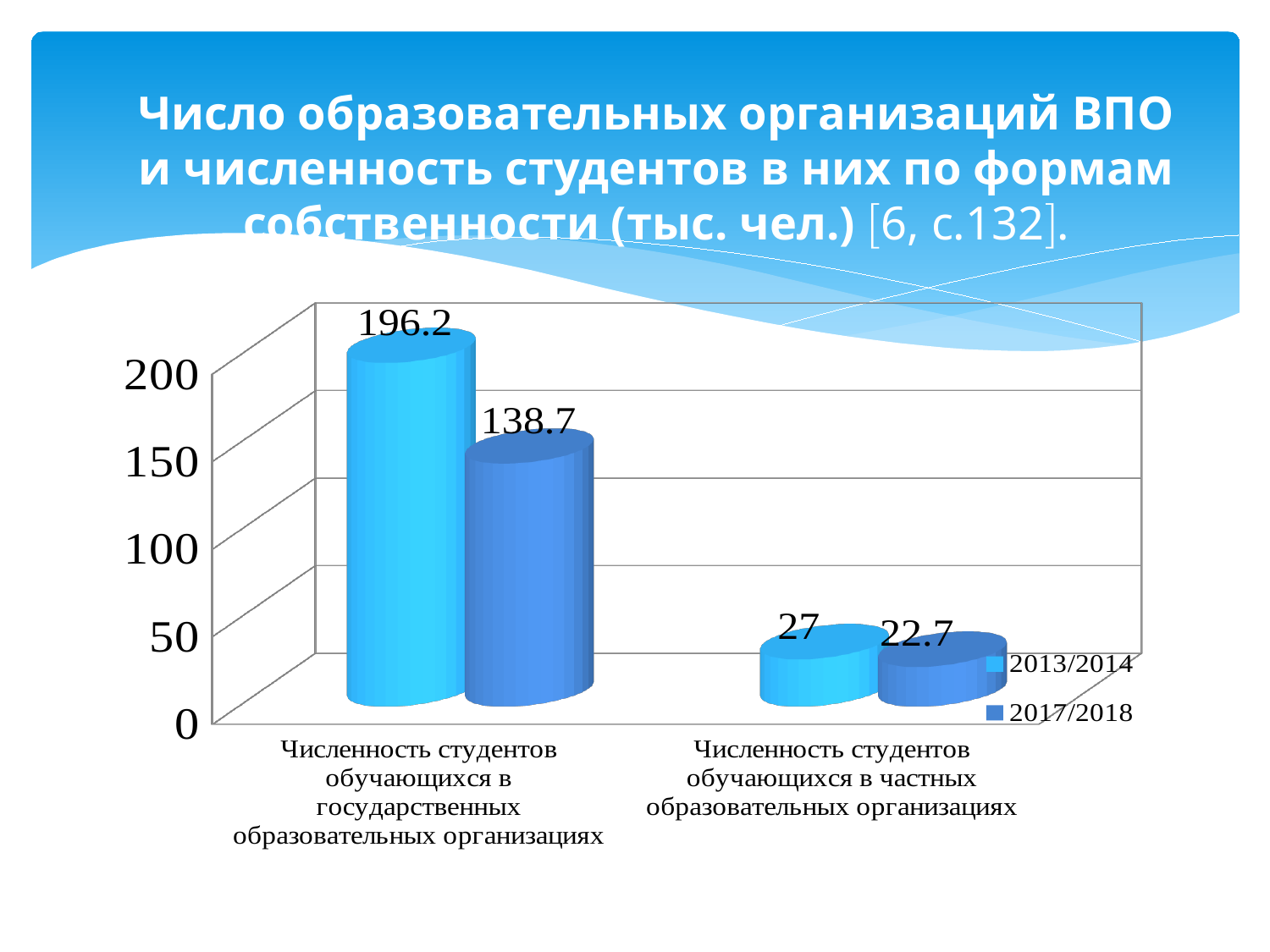
How many categories are shown on the x axis? 2 What is the difference between the 2013/2014 and 2017/2018 values for students in private educational organizations? 4.3 How many series does the legend list? 2 Which is larger: the 2017/2018 value for state organizations or the 2013/2014 value for private organizations? 2017/2018 value for state organizations What is the value for students in state educational organizations in 2013/2014? 196.2 What is the value for students in state educational organizations in 2017/2018? 138.7 Which bar has the lowest value on the chart? Private educational organizations, 2017/2018 What is the value for students in private educational organizations in 2017/2018? 22.7 What is the value for students in private educational organizations in 2013/2014? 27 Which bar has the highest value on the chart? State educational organizations, 2013/2014 What kind of chart is shown on the slide? Bar chart What is the difference between the 2013/2014 and 2017/2018 values for students in state educational organizations? 57.5